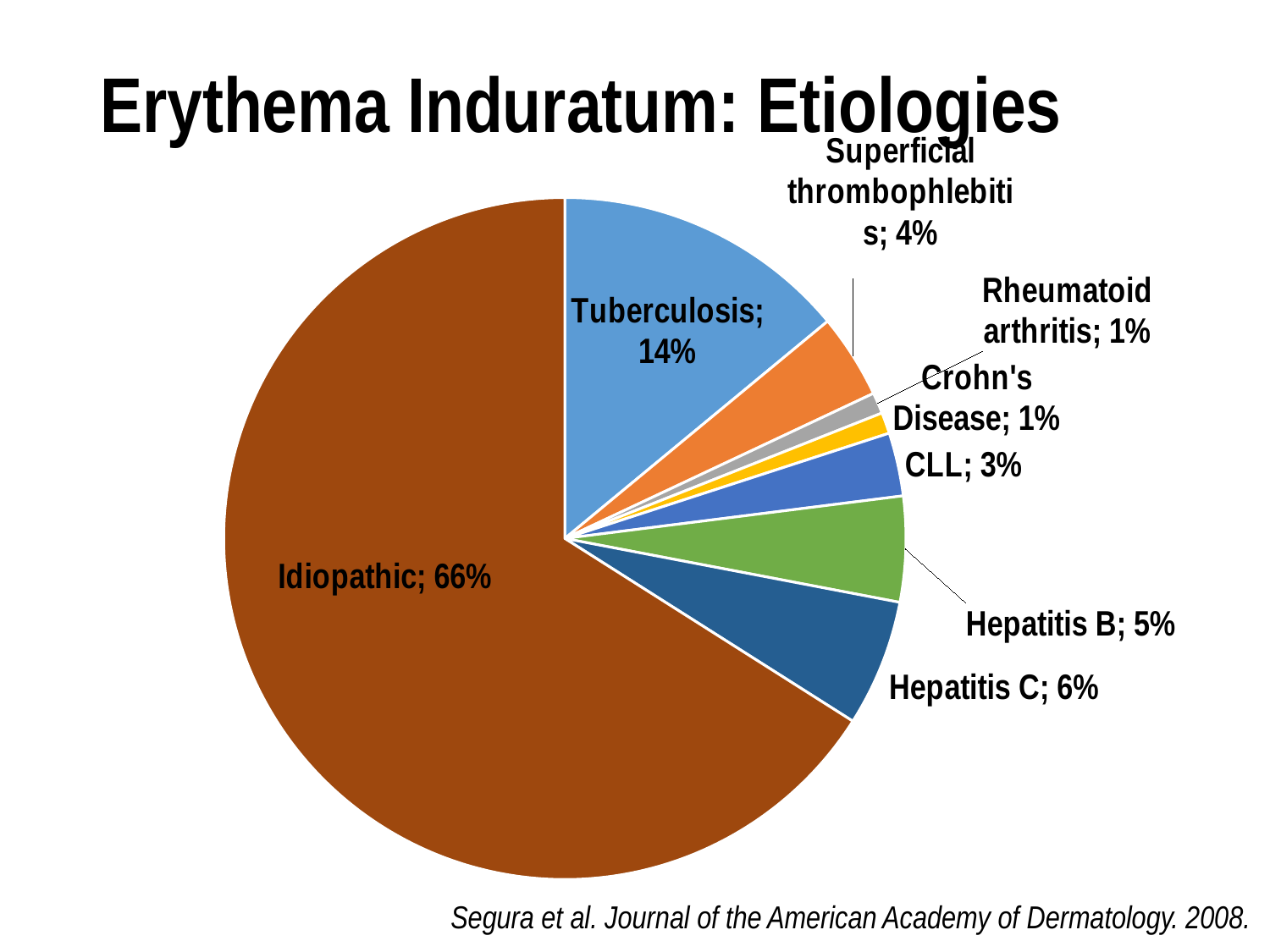
What is the value shown for Tuberculosis? 14% Which is larger, the slice for Hepatitis B or the slice for Hepatitis C? Hepatitis C What is the difference between the Idiopathic and Tuberculosis percentages? 52% What is the value shown for Superficial thrombophlebitis? 4% Which etiology has the largest slice of the pie? Idiopathic What is the value shown for CLL? 3% What type of chart is shown on the slide? Pie chart What is the value shown for Hepatitis C? 6% How many slices does the pie chart have? 8 What colour is the Idiopathic slice? Brown What percentage of the pie is labelled Idiopathic? 66% What is the title of the slide containing the pie chart? Erythema Induratum: Etiologies